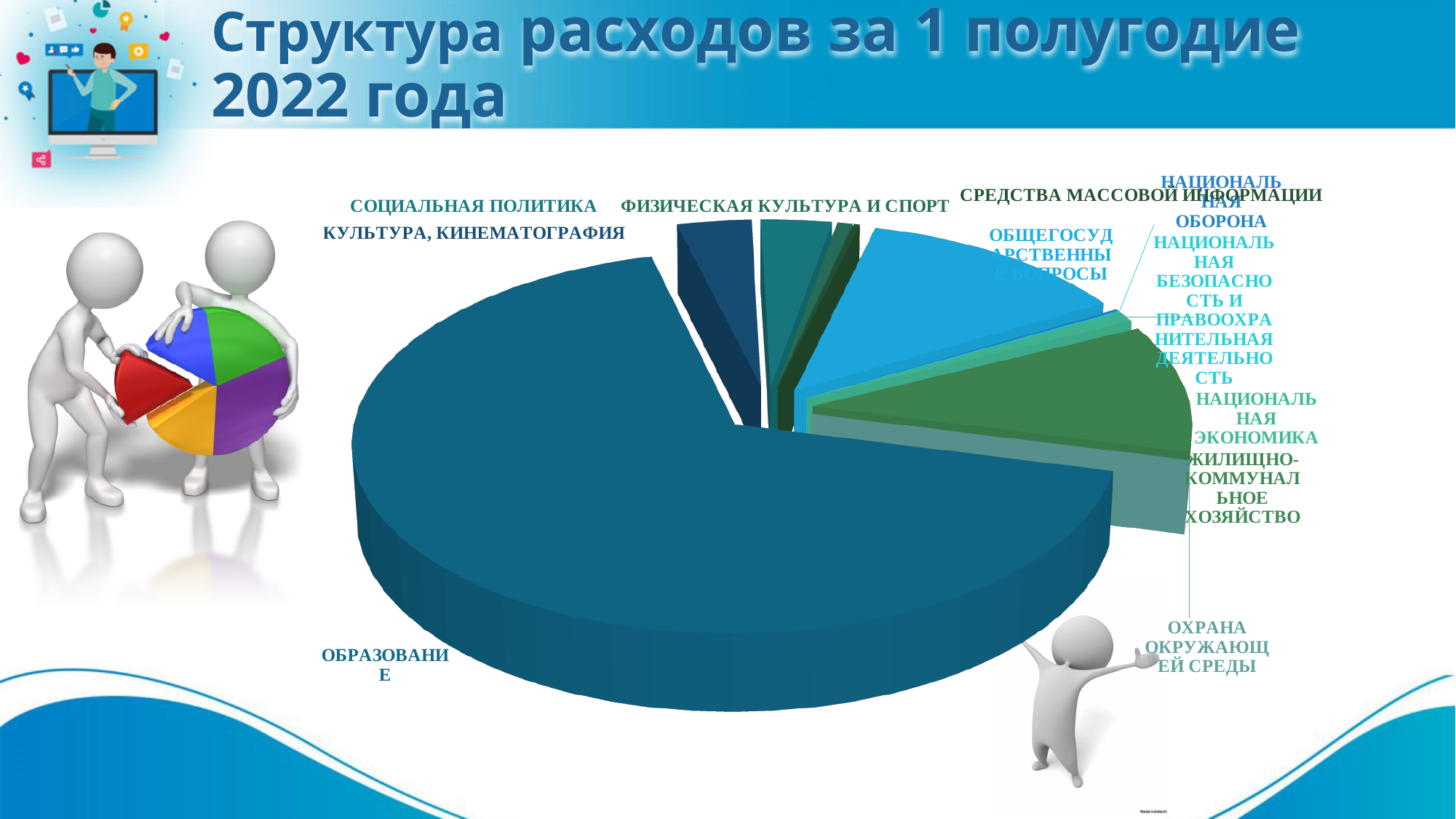
Which category has the largest share of the pie chart? Образование What is the title of the slide containing the pie chart? Структура расходов за 1 полугодие 2022 года Which slice is larger: Образование or Национальная экономика? Образование Which slice is larger: Образование or Общегосударственные вопросы? Образование Which period does the expenditure structure chart cover? 1 полугодие 2022 года Which slice is larger: Национальная экономика or Социальная политика? Социальная политика How many categories are labelled on the pie chart? 11 What kind of chart is shown on the slide? Pie chart